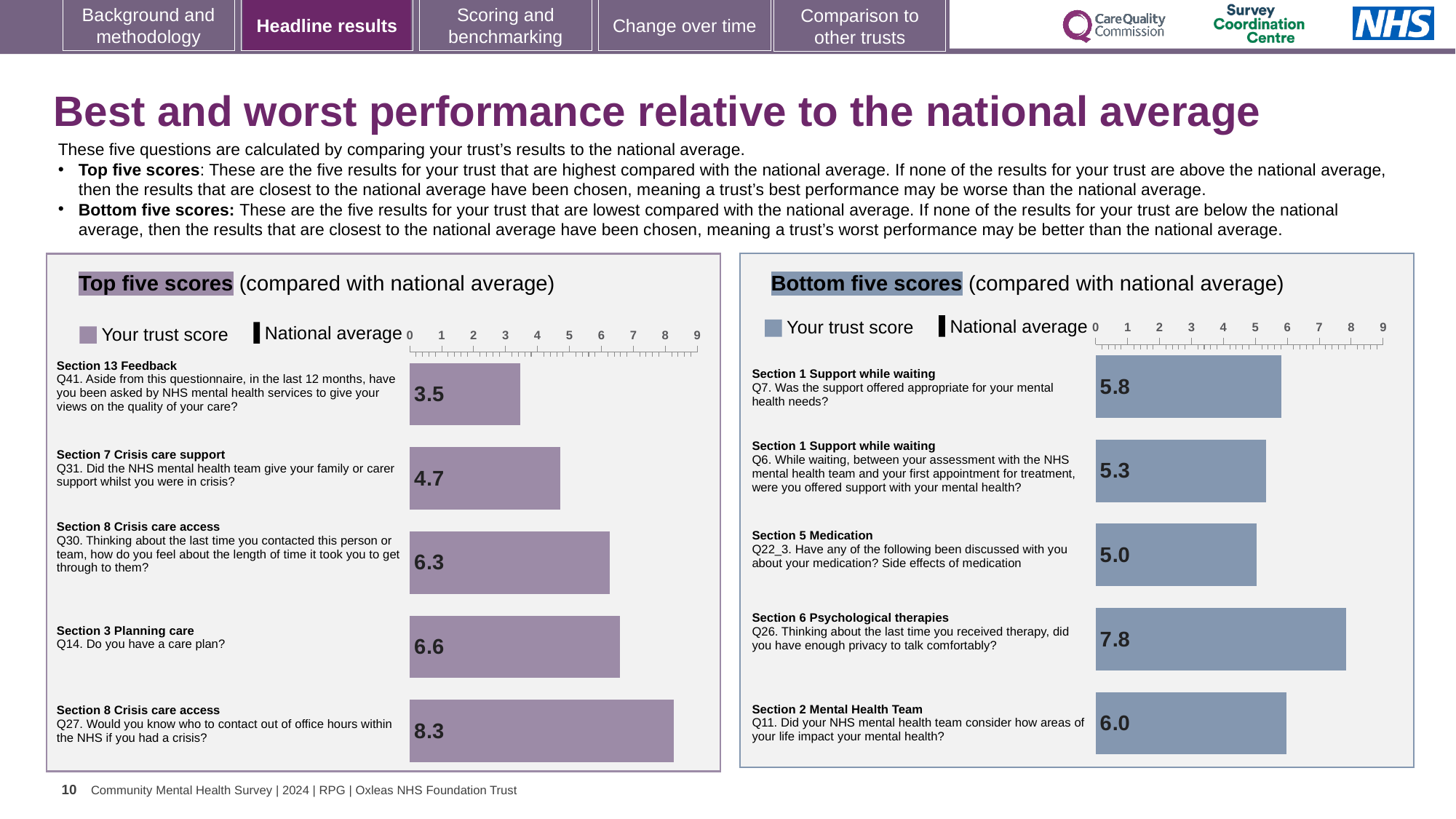
In the Top five scores chart, what is the difference between the trust scores for Q27 and Q41? 4.8 In the Top five scores chart, is the trust score for Q30 greater or less than 5? greater In the Bottom five scores chart, which has the larger trust score: Q7 or Q11? Q11 (6.0) What type of chart is used in the Bottom five scores panel? Bar chart In the Top five scores chart, what is the trust score for Q14 'Do you have a care plan?' 6.6 In the Top five scores chart, which question has the highest trust score? Q27 (8.3) In the Bottom five scores chart, what is the trust score for Q26 about having enough privacy to talk comfortably during therapy? 7.8 How many bars are plotted in the Top five scores chart? 5 In the Top five scores chart, what is the trust score for Q31 about the NHS mental health team giving family or carer support during a crisis? 4.7 In the Bottom five scores chart, which question has the lowest trust score? Q22_3 (5.0) In the Bottom five scores chart, what is the difference between the trust scores for Q26 and Q6? 2.5 How many entries does the legend of the Top five scores chart list? 2